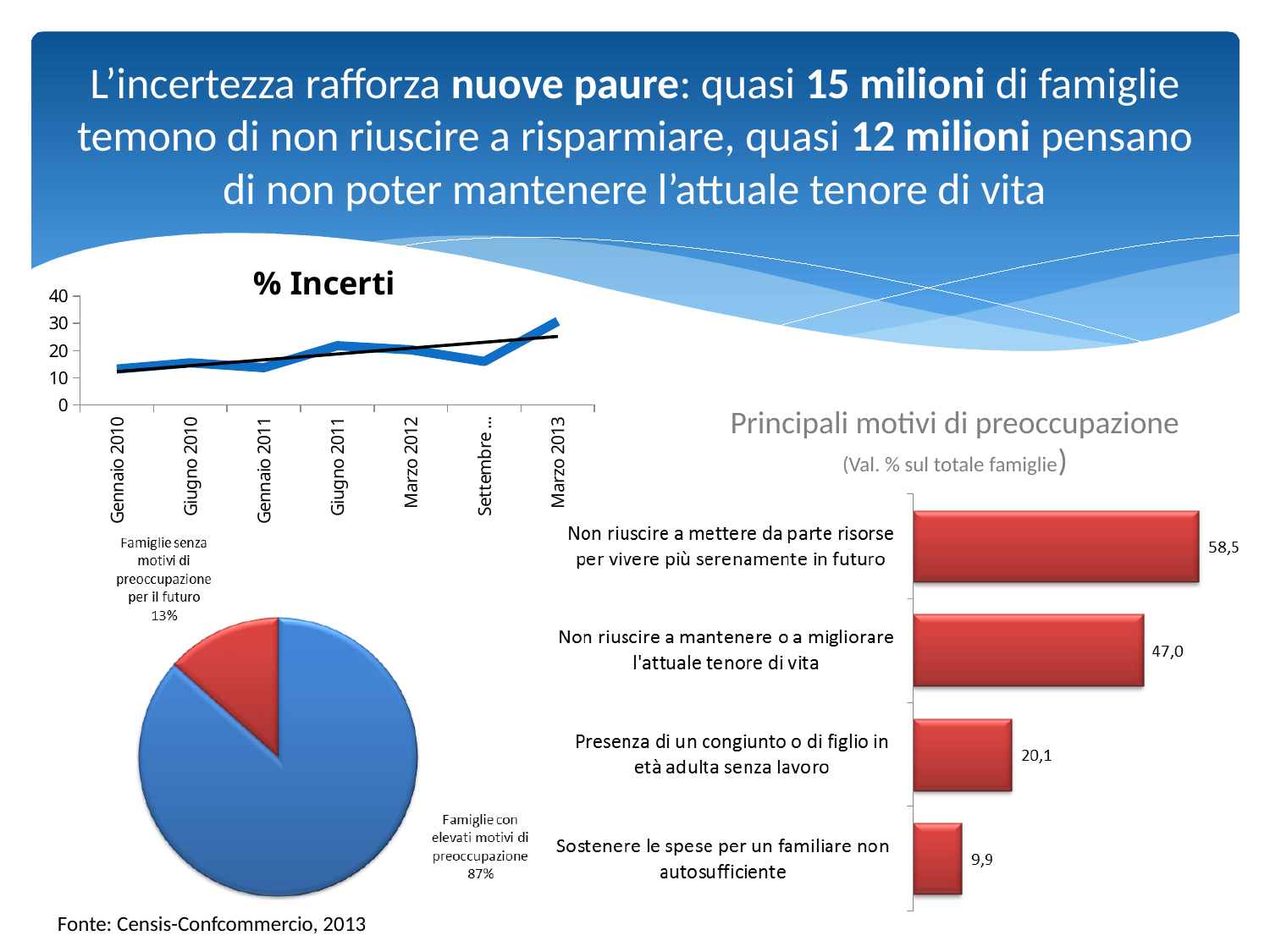
In the line chart '% Incerti', is the value for Gennaio 2010 greater or less than 20? less In the line chart '% Incerti', do the values generally rise or fall from Gennaio 2010 to Marzo 2013? Rise In the bar chart 'Principali motivi di preoccupazione', what is the difference between 'Non riuscire a mettere da parte risorse per vivere più serenamente in futuro' and 'Non riuscire a mantenere o a migliorare l'attuale tenore di vita'? 11,5 In the pie chart on the lower left, what share is 'Famiglie con elevati motivi di preoccupazione'? 87% In the bar chart 'Principali motivi di preoccupazione', which category has the lowest value? Sostenere le spese per un familiare non autosufficiente In the bar chart 'Principali motivi di preoccupazione', what is the value for 'Non riuscire a mettere da parte risorse per vivere più serenamente in futuro'? 58,5 In the bar chart 'Principali motivi di preoccupazione', what is the value for 'Sostenere le spese per un familiare non autosufficiente'? 9,9 In the line chart '% Incerti', is the value for Marzo 2013 greater or less than 20? greater In the bar chart 'Principali motivi di preoccupazione', how many categories are shown? 4 In the line chart '% Incerti', how many time points are plotted on the x axis? 7 What kind of chart is 'Principali motivi di preoccupazione'? Bar chart In the pie chart on the lower left, what share is 'Famiglie senza motivi di preoccupazione per il futuro'? 13%